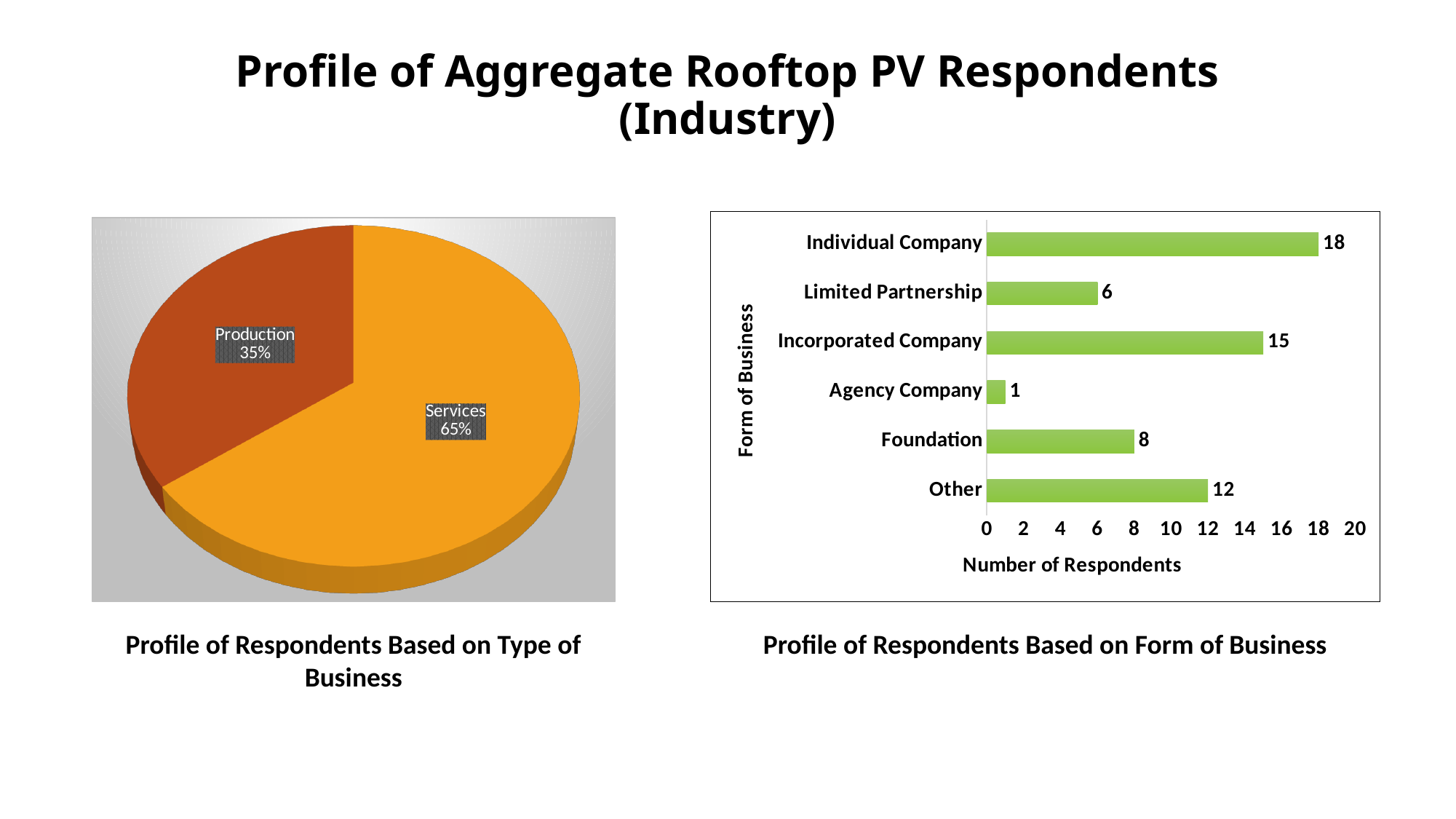
In the bar chart on the right, which form of business has the most respondents? Individual Company What kind of chart is the chart on the right? Bar chart In the bar chart on the right, how many respondents are Foundations? 8 In the pie chart on the left, which type of business has the larger share? Services In the bar chart on the right, how many forms of business are listed? 6 In the bar chart on the right, how many respondents are Individual Companies? 18 In the pie chart on the left, what share of respondents are in Production? 35% In the bar chart on the right, what is the difference in respondents between Incorporated Company and Limited Partnership? 9 In the bar chart on the right, which form of business has the fewest respondents? Agency Company What kind of chart is the chart on the left? Pie chart In the pie chart on the left, what share of respondents are in Services? 65% In the bar chart on the right, which has more respondents, Other or Foundation? Other